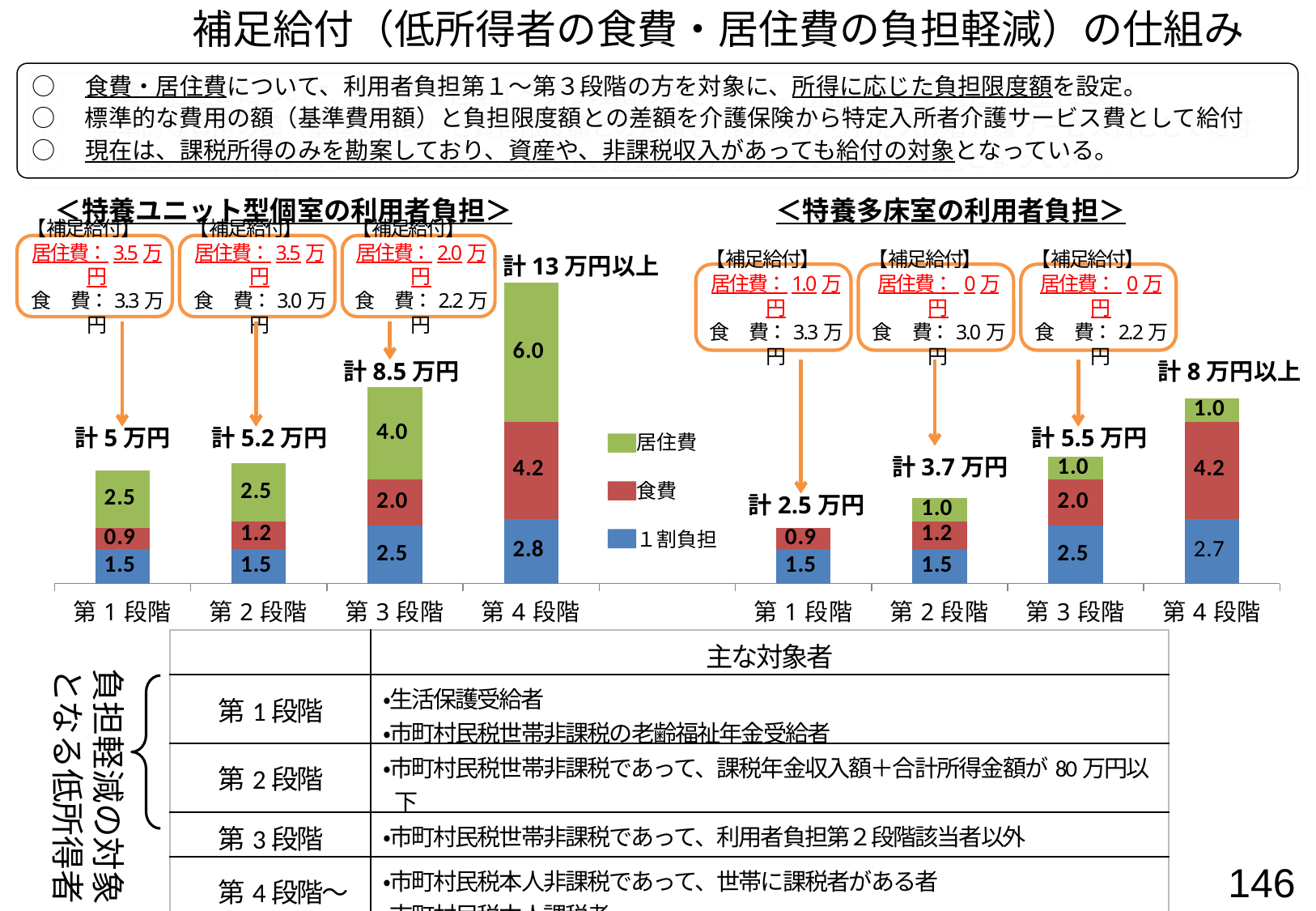
In the left chart (特養ユニット型個室の利用者負担), what is the difference between the 食費 value for 第４段階 and for 第１段階? 3.3 In the right chart (特養多床室の利用者負担), how many categories are shown on the x axis? 4 In the right chart (特養多床室の利用者負担), which has the larger １割負担 value, 第２段階 or 第３段階? 第３段階 In the right chart (特養多床室の利用者負担), what is the １割負担 value for 第４段階? 2.7 In the left chart (特養ユニット型個室の利用者負担), which category has the highest 居住費 value? 第４段階 In the left chart (特養ユニット型個室の利用者負担), how many series does the legend list? 3 In the left chart (特養ユニット型個室の利用者負担), what is the 居住費 value for 第３段階? 4.0 In the left chart (特養ユニット型個室の利用者負担), what is the total of the stacked bar for 第３段階? 8.5万円 In the legend between the two charts, what colour represents 居住費? Green In the left chart (特養ユニット型個室の利用者負担), do the １割負担 values rise or fall from 第１段階 to 第４段階? Rise In the right chart (特養多床室の利用者負担), what is the 食費 value for 第４段階? 4.2 What kind of chart is the left chart titled ＜特養ユニット型個室の利用者負担＞? Stacked bar chart